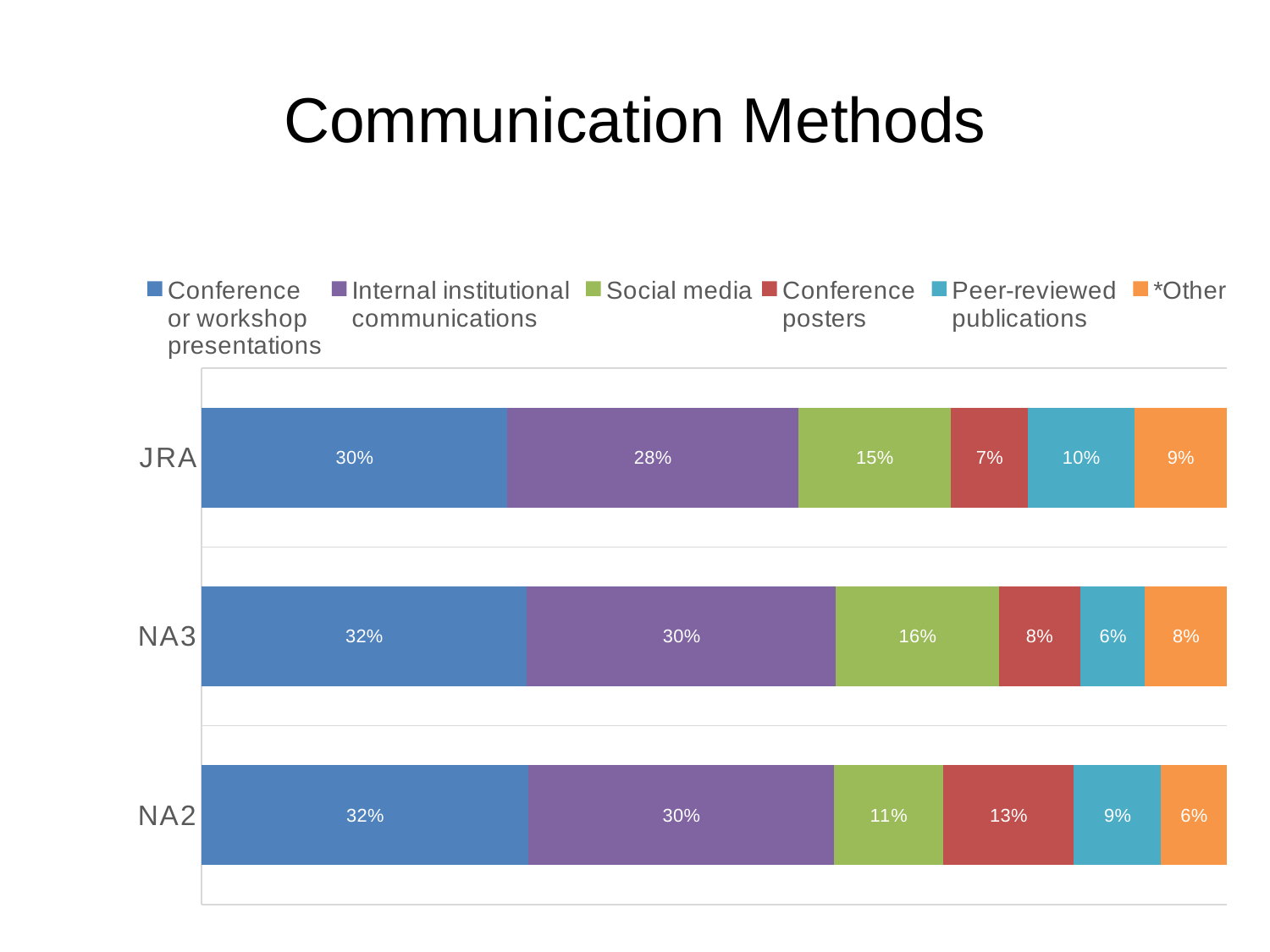
What is the title of the chart? Communication Methods Which is larger: Peer-reviewed publications for JRA or for NA2? JRA What kind of chart is shown on the slide? Stacked bar chart How many series does the legend list? 6 What is the value for *Other in the JRA bar? 9% What is the value for Conference posters in the NA2 bar? 13% How many categories (bars) are shown on the chart? 3 What is the value for Peer-reviewed publications in the NA3 bar? 6% Which category has the lowest value for Social media? NA2 Which category has the highest value for Conference posters? NA2 What is the difference between the Social media values for NA3 and NA2? 5% What is the value for Social media in the JRA bar? 15%